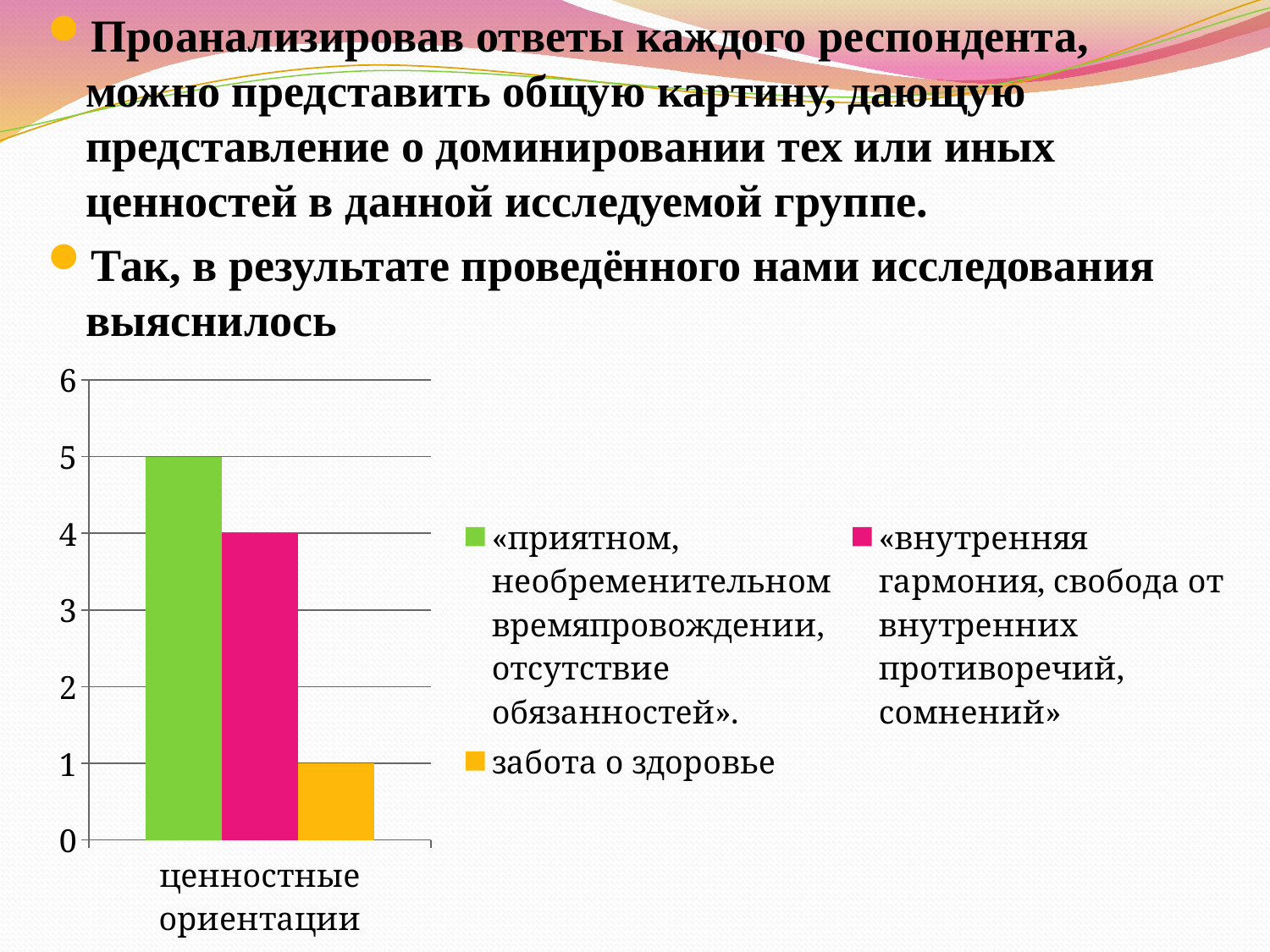
What is the value of the «внутренняя гармония, свобода от внутренних противоречий, сомнений» bar? 4 Which series has the lowest value in the chart? забота о здоровье How many categories are shown on the x axis of the chart? 1 Is the value for «внутренняя гармония, свобода от внутренних противоречий, сомнений» greater or less than 3? greater What is the value of the «забота о здоровье» bar? 1 What is the label of the category on the x axis of the chart? ценностные ориентации Which is larger: the «внутренняя гармония, свобода от внутренних противоречий, сомнений» bar or the «забота о здоровье» bar? «внутренняя гармония, свобода от внутренних противоречий, сомнений» How many series does the chart legend list? 3 Which series has the highest value in the chart? «приятном, необременительном времяпровождении, отсутствие обязанностей» What is the value of the «приятном, необременительном времяпровождении, отсутствие обязанностей» bar? 5 What is the difference between the «приятном, необременительном времяпровождении, отсутствие обязанностей» bar and the «забота о здоровье» bar? 4 What kind of chart is shown on the slide? bar chart